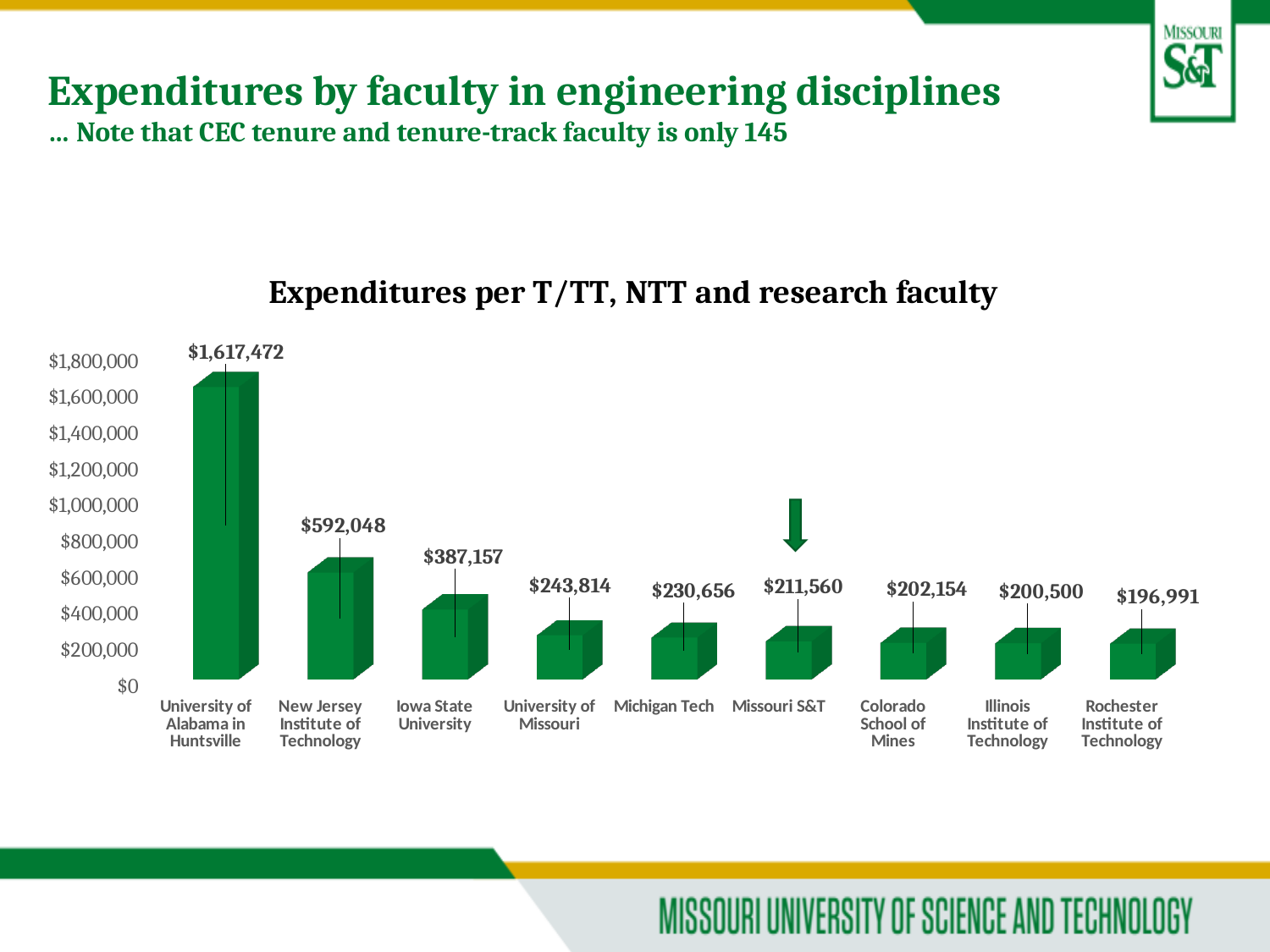
Which university has the lowest expenditures per faculty? Rochester Institute of Technology Is the value for New Jersey Institute of Technology greater or less than $400,000? greater What is the value for Missouri S&T? $211,560 What is the difference between the values for Missouri S&T and Colorado School of Mines? $9,406 What is the value for Michigan Tech? $230,656 What is the difference between the values for University of Alabama in Huntsville and New Jersey Institute of Technology? $1,025,424 How many universities are shown in the chart? 9 What is the title of the chart? Expenditures per T/TT, NTT and research faculty What kind of chart is shown on the slide? Bar chart Which is larger, the value for University of Missouri or the value for Illinois Institute of Technology? University of Missouri What is the value for Iowa State University? $387,157 Which university has the highest expenditures per faculty? University of Alabama in Huntsville